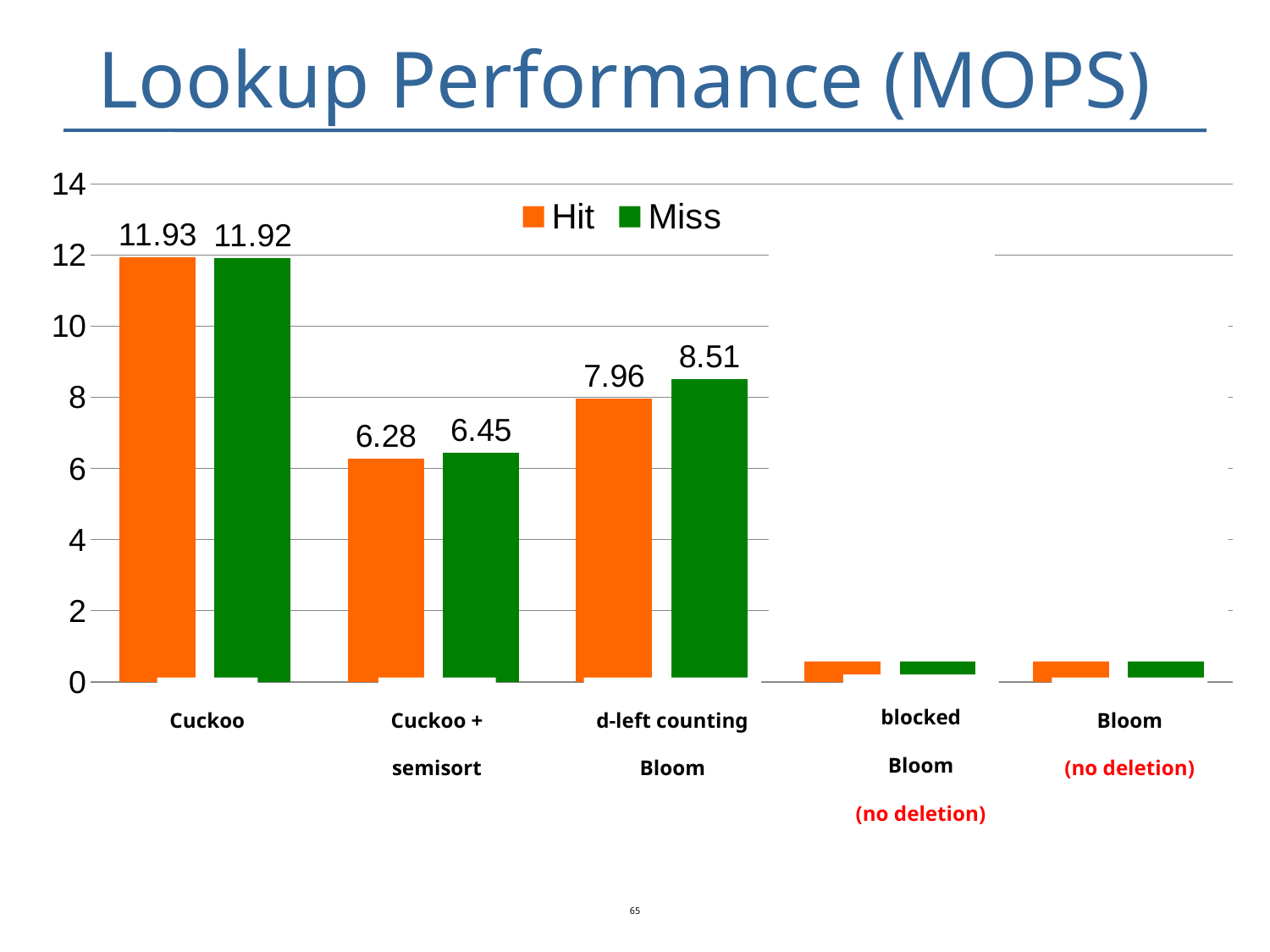
How many categories are shown on the x axis? 5 What is the difference between the Hit values for Cuckoo and Cuckoo + semisort? 5.65 How many series does the legend list? 2 What kind of chart is shown on the slide? bar chart What is the Miss value for Cuckoo + semisort? 6.45 What is the Hit value for d-left counting Bloom? 7.96 Which category has the highest Hit value? Cuckoo Is the Hit value for blocked Bloom (no deletion) greater or less than 2? less What is the difference between the Miss and Hit values for d-left counting Bloom? 0.55 What is the Hit value for Cuckoo? 11.93 What is the Miss value for d-left counting Bloom? 8.51 For d-left counting Bloom, which is larger, the Hit value or the Miss value? Miss